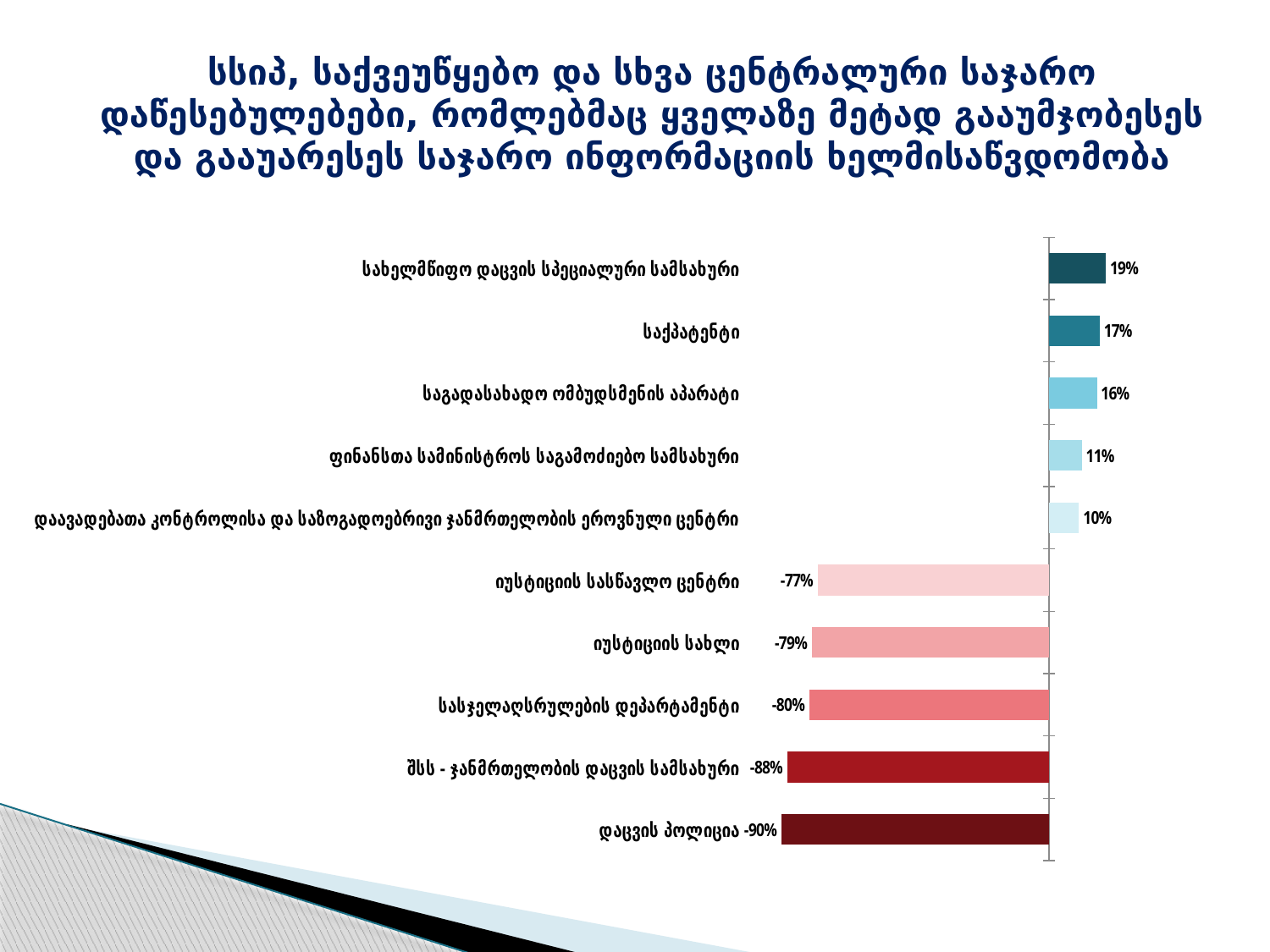
Which category has the lowest value? დაცვის პოლიცია Which category has the highest value? სახელმწიფო დაცვის სპეციალური სამსახური How many categories have negative values? 5 What is the value for დაცვის პოლიცია? -90% What is the value for იუსტიციის სახლი? -79% What kind of chart is shown on the slide? Bar chart What is the value for საქპატენტი? 17% How many categories are shown in the chart? 10 What is the difference between the values for სახელმწიფო დაცვის სპეციალური სამსახური and საქპატენტი? 2% What is the difference between the values for იუსტიციის სასწავლო ცენტრი and დაცვის პოლიცია? 13% What is the value for სახელმწიფო დაცვის სპეციალური სამსახური? 19% Which has a larger value, საგადასახადო ომბუდსმენის აპარატი or ფინანსთა სამინისტროს საგამოძიებო სამსახური? საგადასახადო ომბუდსმენის აპარატი